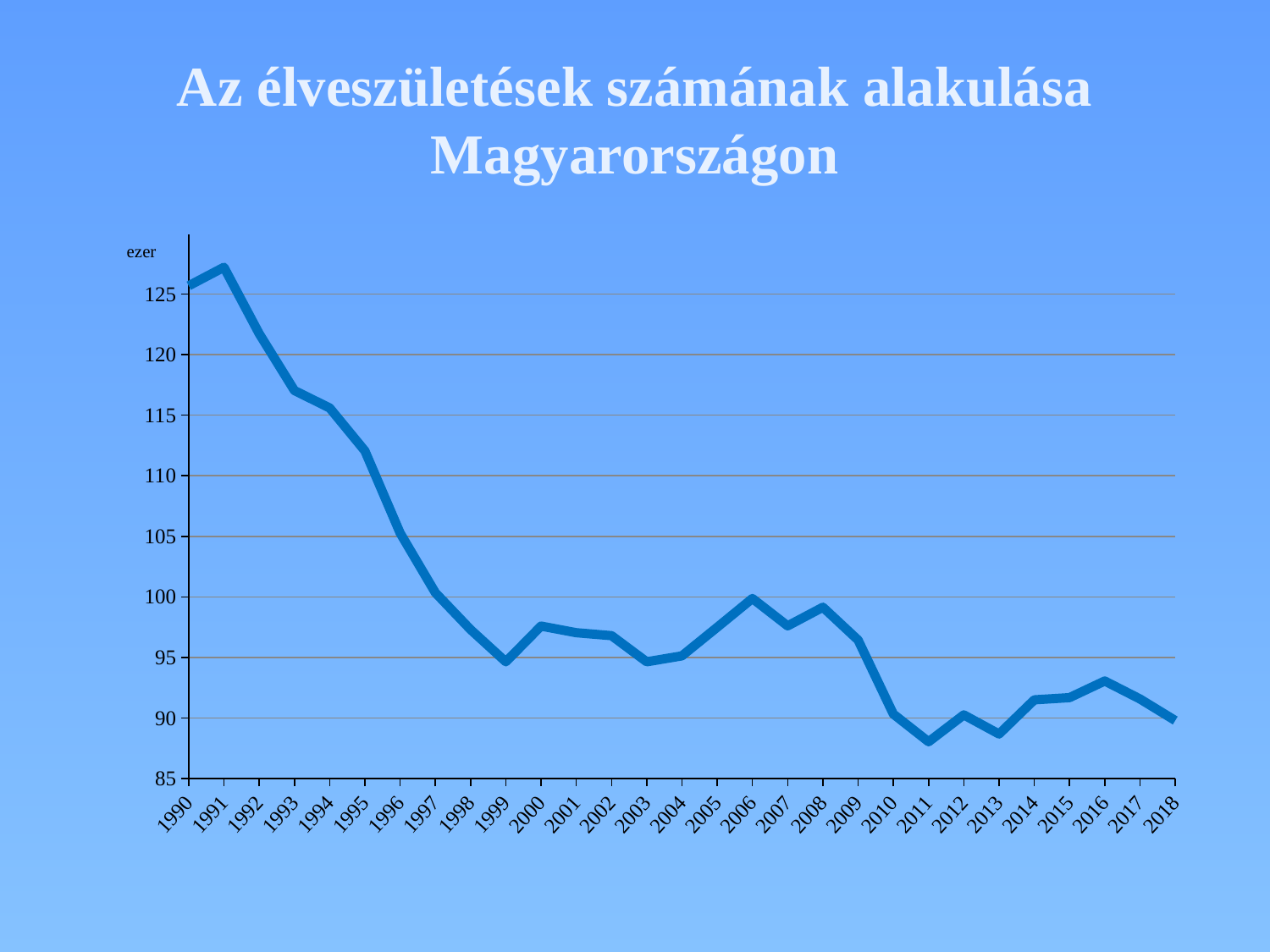
Which year has the highest value? 1991 Overall, do the values rise or fall from 1990 to 2018? fall Is the value for 2016 greater or less than 90? greater Which is larger, the value for 2006 or the value for 2011? 2006 How many years are plotted along the x axis? 29 What unit label is shown at the top of the y axis? ezer Is the value for 2011 greater or less than 90? less Which is larger, the value for 1995 or the value for 2000? 1995 Is the value for 1991 greater or less than 125? greater What kind of chart is shown on the slide? line chart Which year has the lowest value? 2011